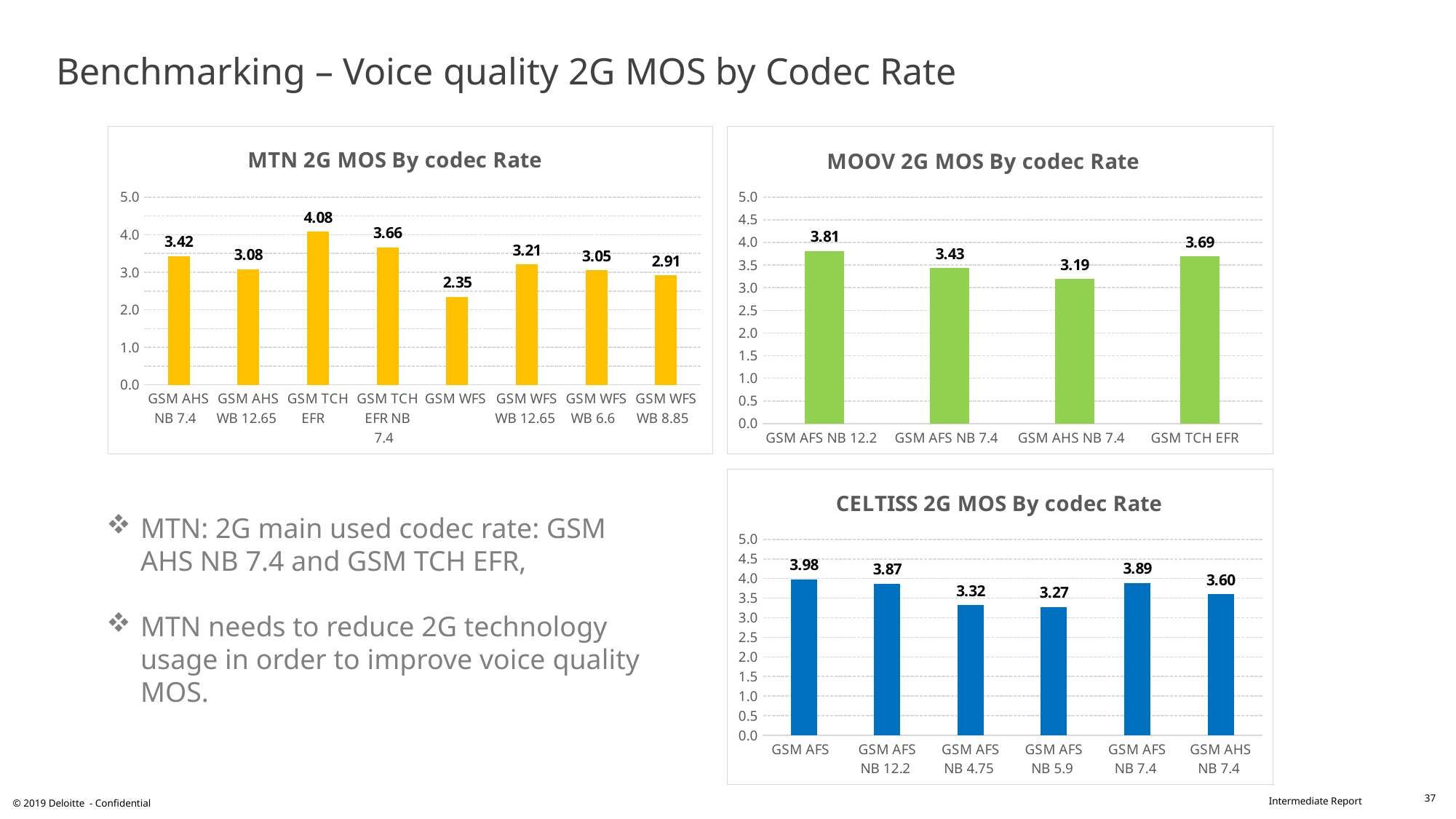
In the 'CELTISS 2G MOS By codec Rate' chart, which is larger: GSM AFS NB 12.2 or GSM AFS NB 4.75? GSM AFS NB 12.2 In the 'MOOV 2G MOS By codec Rate' chart, how many codec rate categories are shown? 4 In the 'MTN 2G MOS By codec Rate' chart, what is the value for GSM TCH EFR? 4.08 In the 'MTN 2G MOS By codec Rate' chart, which codec rate has the lowest MOS? GSM WFS In the 'CELTISS 2G MOS By codec Rate' chart, what is the value for GSM AHS NB 7.4? 3.60 What kind of chart is the 'CELTISS 2G MOS By codec Rate' chart? Bar chart In the 'MOOV 2G MOS By codec Rate' chart, which codec rate has the highest MOS? GSM AFS NB 12.2 In the 'MTN 2G MOS By codec Rate' chart, what is the difference between GSM TCH EFR and GSM WFS? 1.73 In the 'CELTISS 2G MOS By codec Rate' chart, which codec rate has the lowest MOS? GSM AFS NB 5.9 In the 'MTN 2G MOS By codec Rate' chart, how many codec rate categories are shown? 8 What colour are the bars in the 'MOOV 2G MOS By codec Rate' chart? Green In the 'MOOV 2G MOS By codec Rate' chart, what is the value for GSM AFS NB 7.4? 3.43